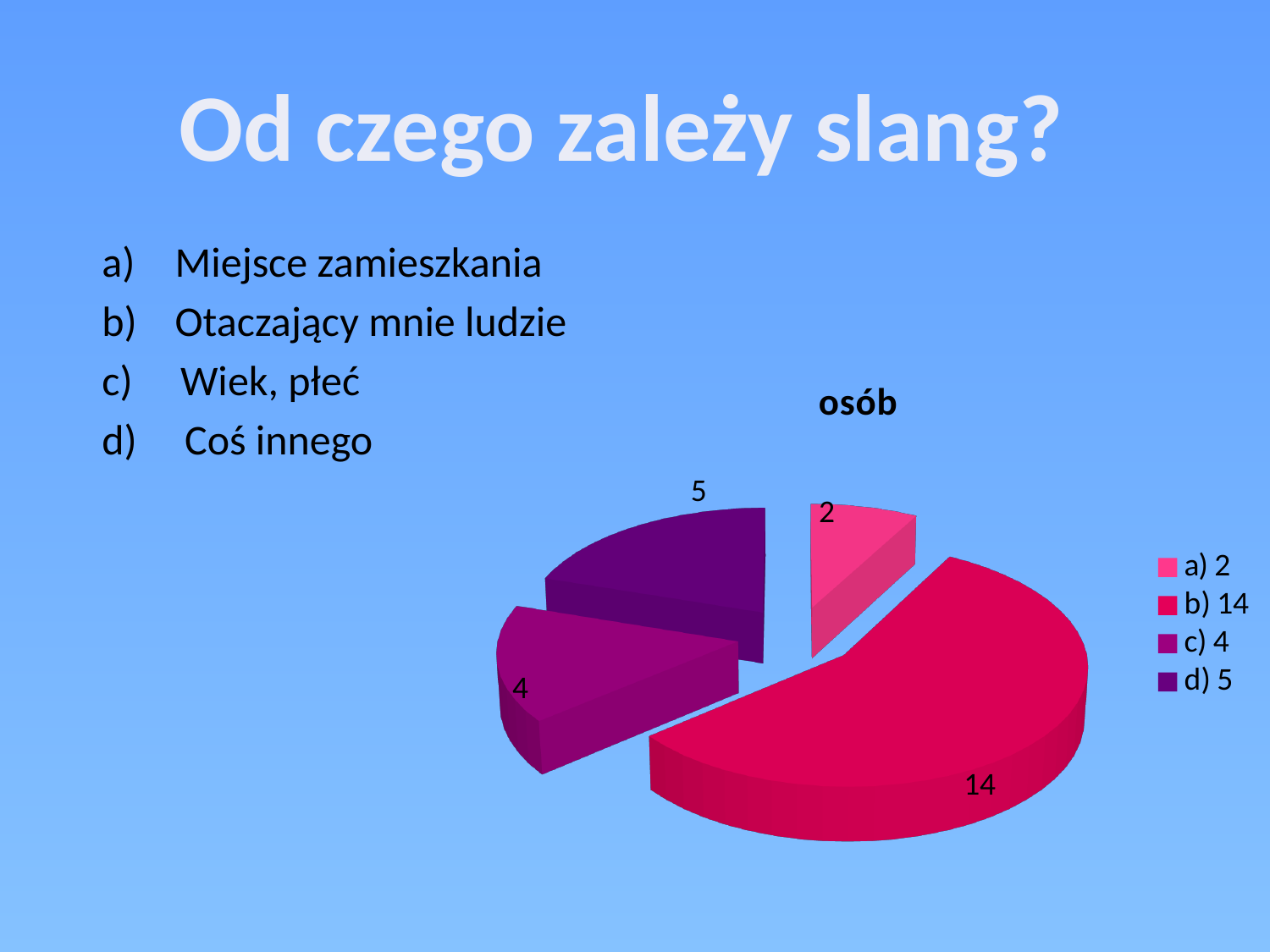
Which answer has the largest slice in the pie chart? b) How many slices does the pie chart have? 4 What type of chart is shown on the slide? pie chart What is the title of the chart? osób Which is larger, the value for answer c) or the value for answer d)? d) How many entries does the chart legend list? 4 What is the value of the slice for answer b)? 14 What is the value of the slice for answer a)? 2 What is the value of the slice for answer d)? 5 What share of the pie does the slice for answer b) represent? 56% Which answer has the smallest slice in the pie chart? a) What is the difference between the values for answer b) and answer d)? 9